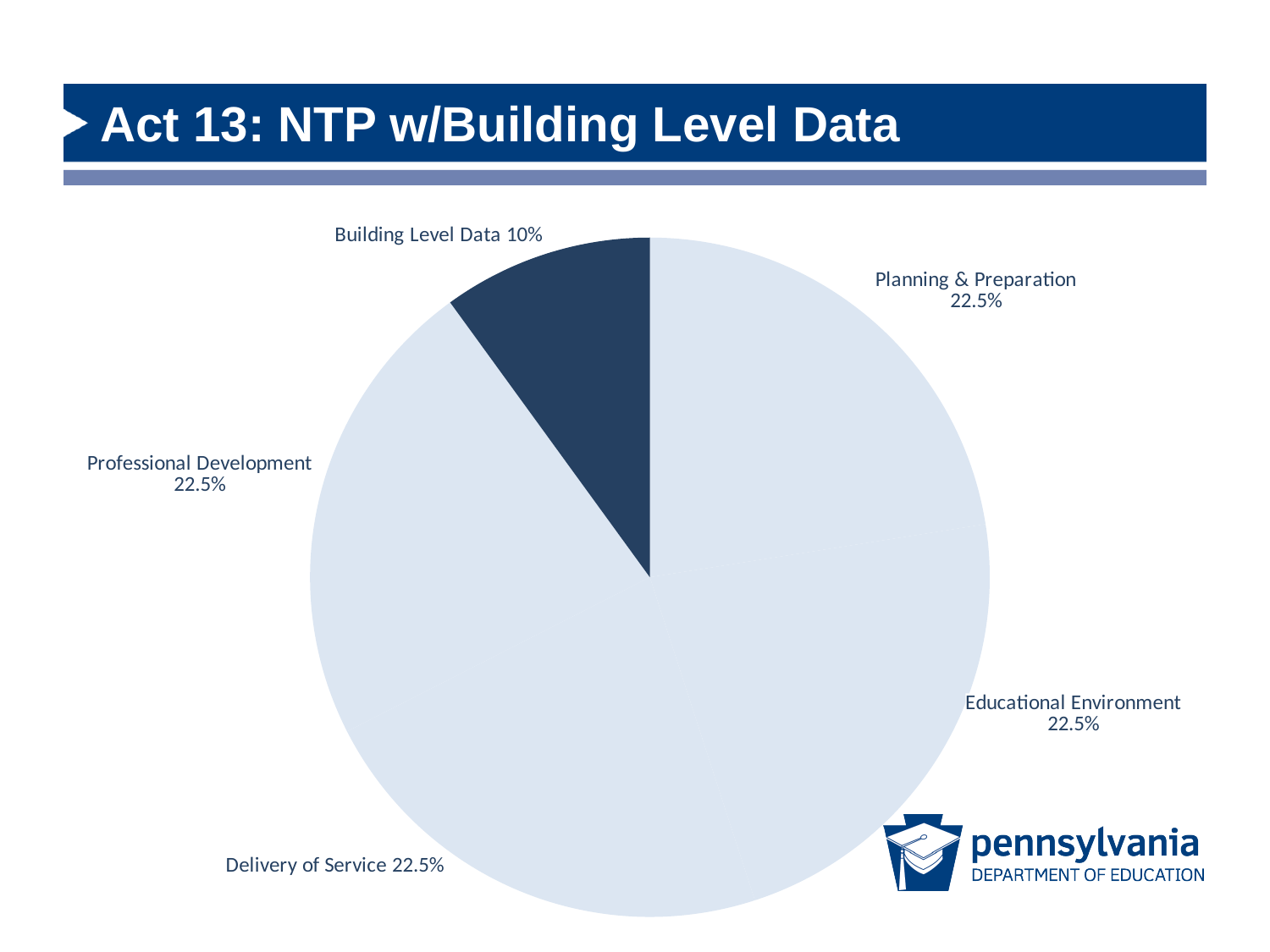
What is the value for Delivery of Service? 22.5% What is the difference between the Planning & Preparation value and the Building Level Data value? 12.5% How many categories are shown in the pie chart? 5 What share of the pie does Building Level Data represent? 10% What is the value for Planning & Preparation? 22.5% What is the value for Professional Development? 22.5% What is the combined total of the four 22.5% categories? 90% Which is larger, the value for Delivery of Service or the value for Building Level Data? Delivery of Service Which category has the smallest slice of the pie? Building Level Data What is the value for Educational Environment? 22.5% What kind of chart is shown on the slide? Pie chart What is the title of the slide containing the pie chart? Act 13: NTP w/Building Level Data